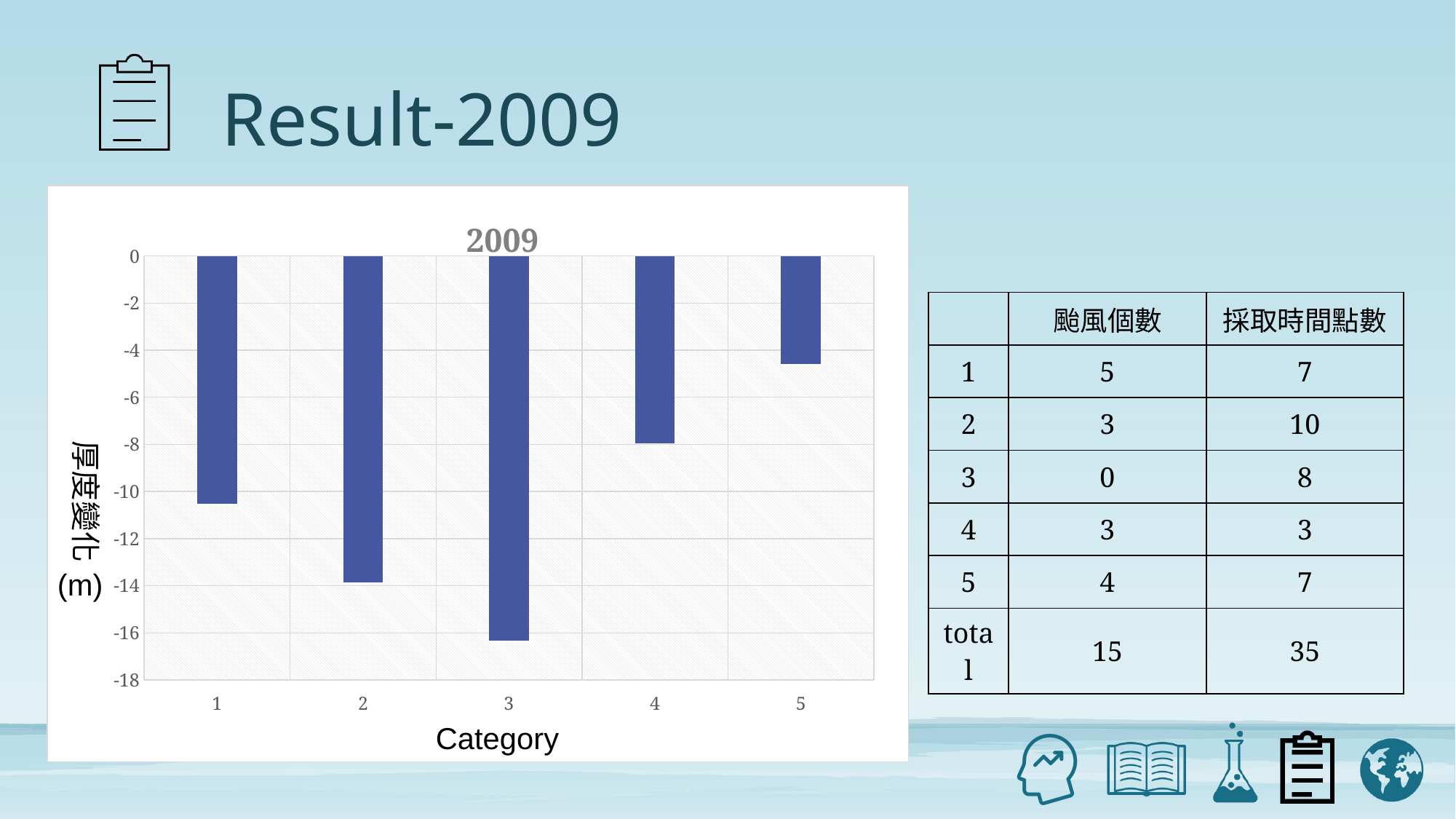
What kind of chart is shown on the slide? bar chart Is the value for category 5 greater or less than -6? greater What is the title of the chart? 2009 Which category has the lowest (most negative) value in the chart? 3 Is the value for category 3 greater or less than -14? less Which has the larger (less negative) value, category 1 or category 4? 4 Is the value for category 2 greater or less than -12? less How many categories are plotted on the x axis of the chart? 5 Which category has the highest value (closest to zero) in the chart? 5 What is the label on the x axis of the chart? Category Do the values rise or fall from category 3 to category 5? rise